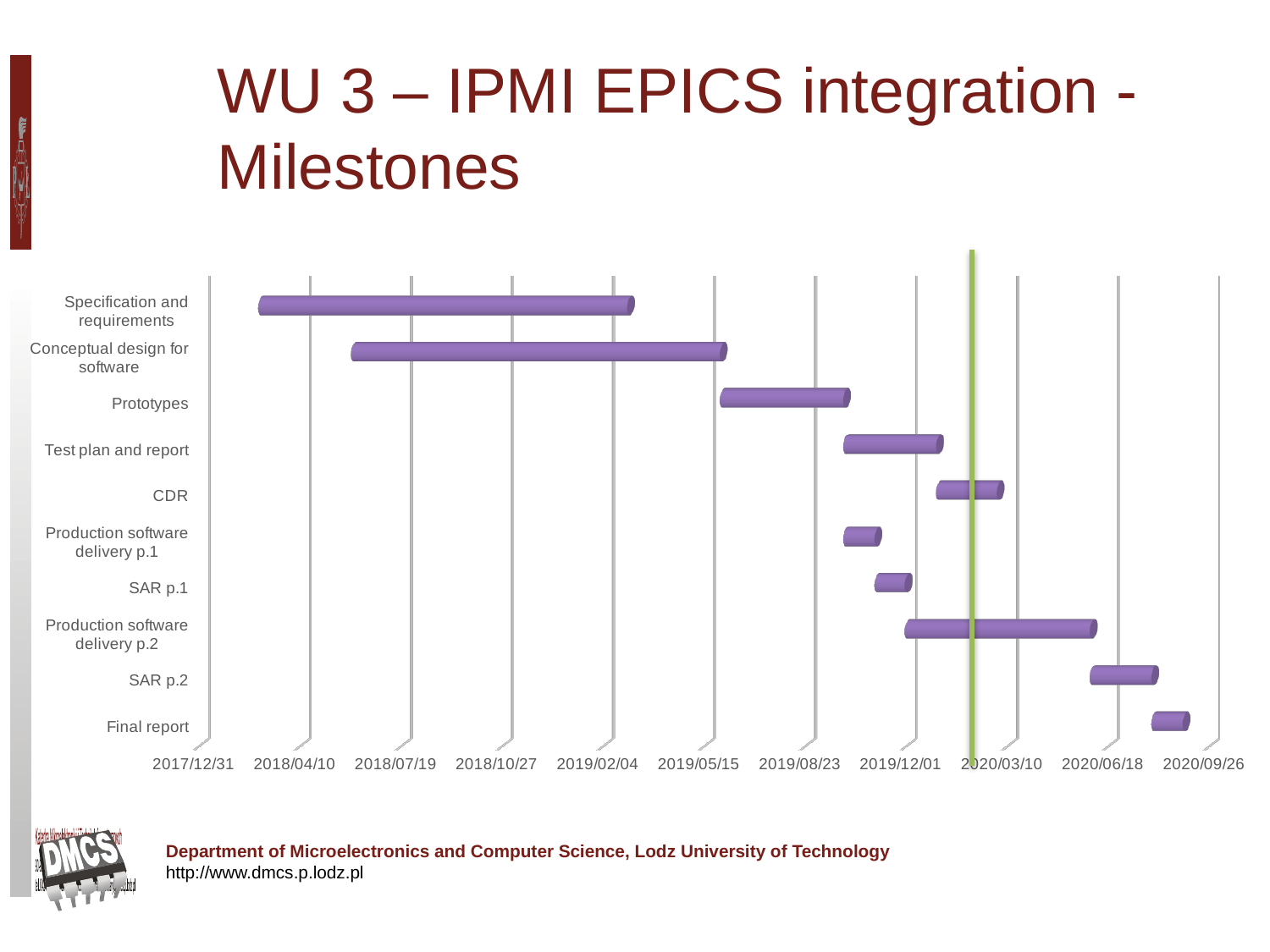
Which task starts earliest in the chart? Specification and requirements What kind of chart is shown on the slide? Bar chart (Gantt chart) Does the bar for Final report end before or after 2020/09/26? before What is the first date label on the horizontal axis? 2017/12/31 Does the bar for Production software delivery p.2 end before or after 2020/06/18? before Does the bar for Test plan and report start before or after 2019/08/23? after Which bar is longer: Production software delivery p.2 or Production software delivery p.1? Production software delivery p.2 Which task ends last in the chart? Final report Which bar is longer: Prototypes or SAR p.1? Prototypes How many tasks are listed on the vertical axis of the chart? 10